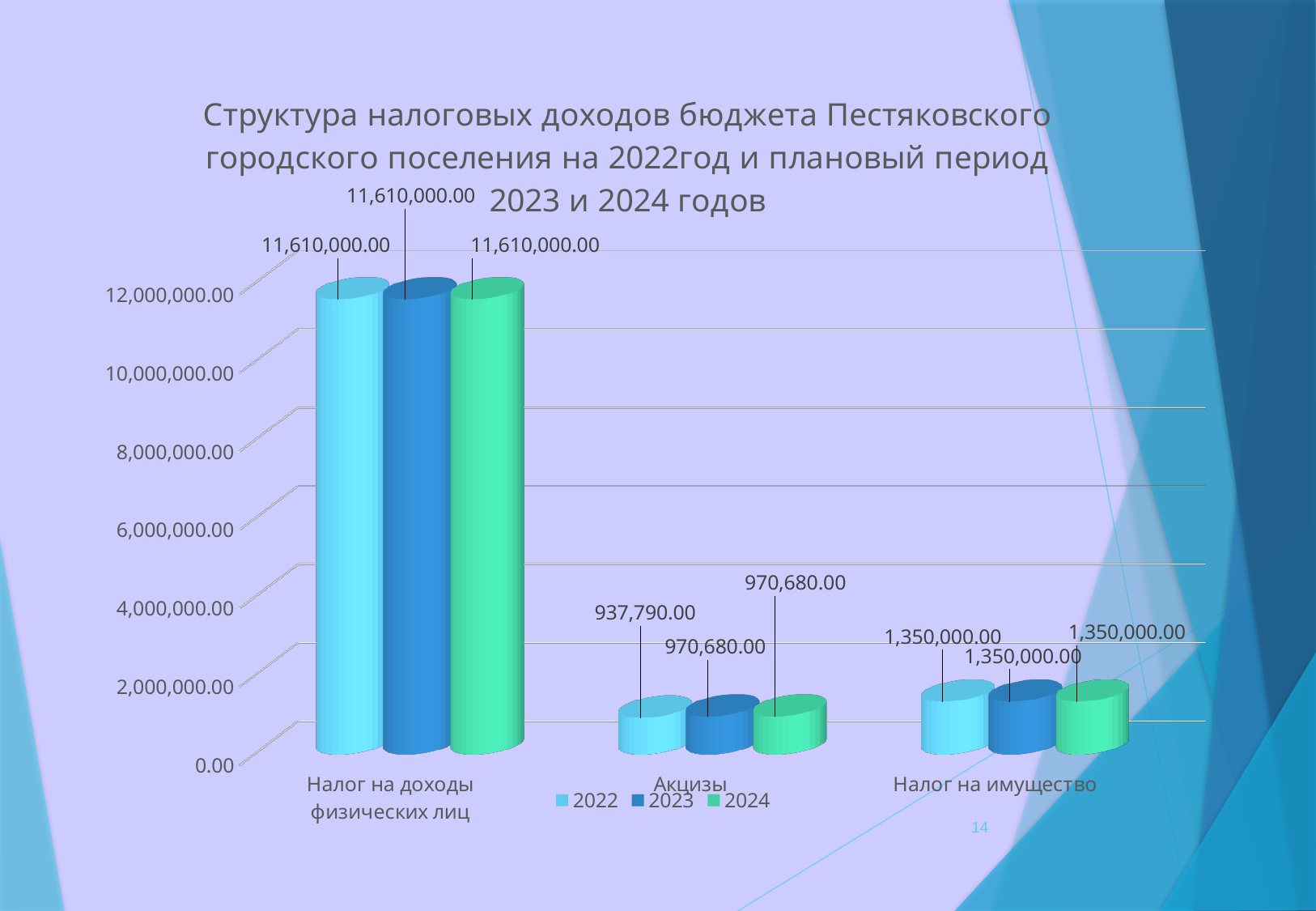
What is the value for Акцизы in 2022? 937,790.00 What is the value for Налог на имущество in 2023? 1,350,000.00 What is the difference between the 2023 and 2022 values for Акцизы? 32,890.00 Is the value for Налог на доходы физических лиц in 2024 greater or less than 10,000,000.00? greater What is the value for Акцизы in 2024? 970,680.00 How many categories are shown on the x axis? 3 What kind of chart is shown on the slide? bar chart What is the value for Налог на доходы физических лиц in 2022? 11,610,000.00 Which category has the lowest value in 2022? Акцизы Which is larger: the 2024 value for Налог на имущество or the 2024 value for Акцизы? Налог на имущество Which category has the highest value in 2023? Налог на доходы физических лиц How many series does the legend list? 3